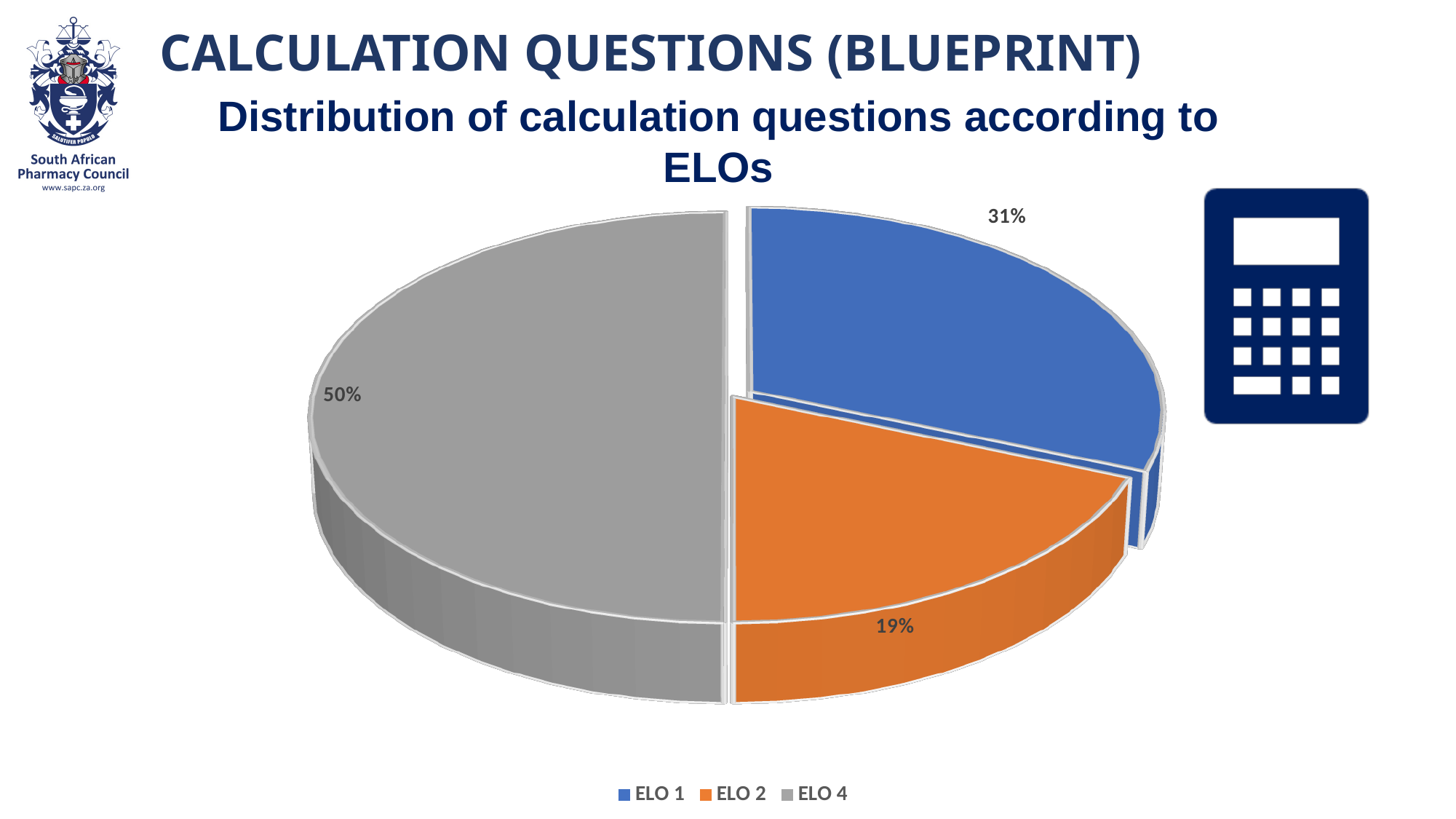
Which colour represents ELO 2 in the pie chart? Orange What is the difference in percentage points between the ELO 1 share and the ELO 2 share? 12 Which has a larger share of calculation questions, ELO 1 or ELO 2? ELO 1 What kind of chart is used to show the distribution of calculation questions? Pie chart What is the title of the chart? Distribution of calculation questions according to ELOs What share of calculation questions is allocated to ELO 1? 31% What share of calculation questions is allocated to ELO 4? 50% How many ELO categories are shown in the pie chart? 3 What is the difference in percentage points between the ELO 4 share and the ELO 1 share? 19 Which ELO has the smallest share of calculation questions? ELO 2 What share of calculation questions is allocated to ELO 2? 19% Which ELO has the largest share of calculation questions? ELO 4